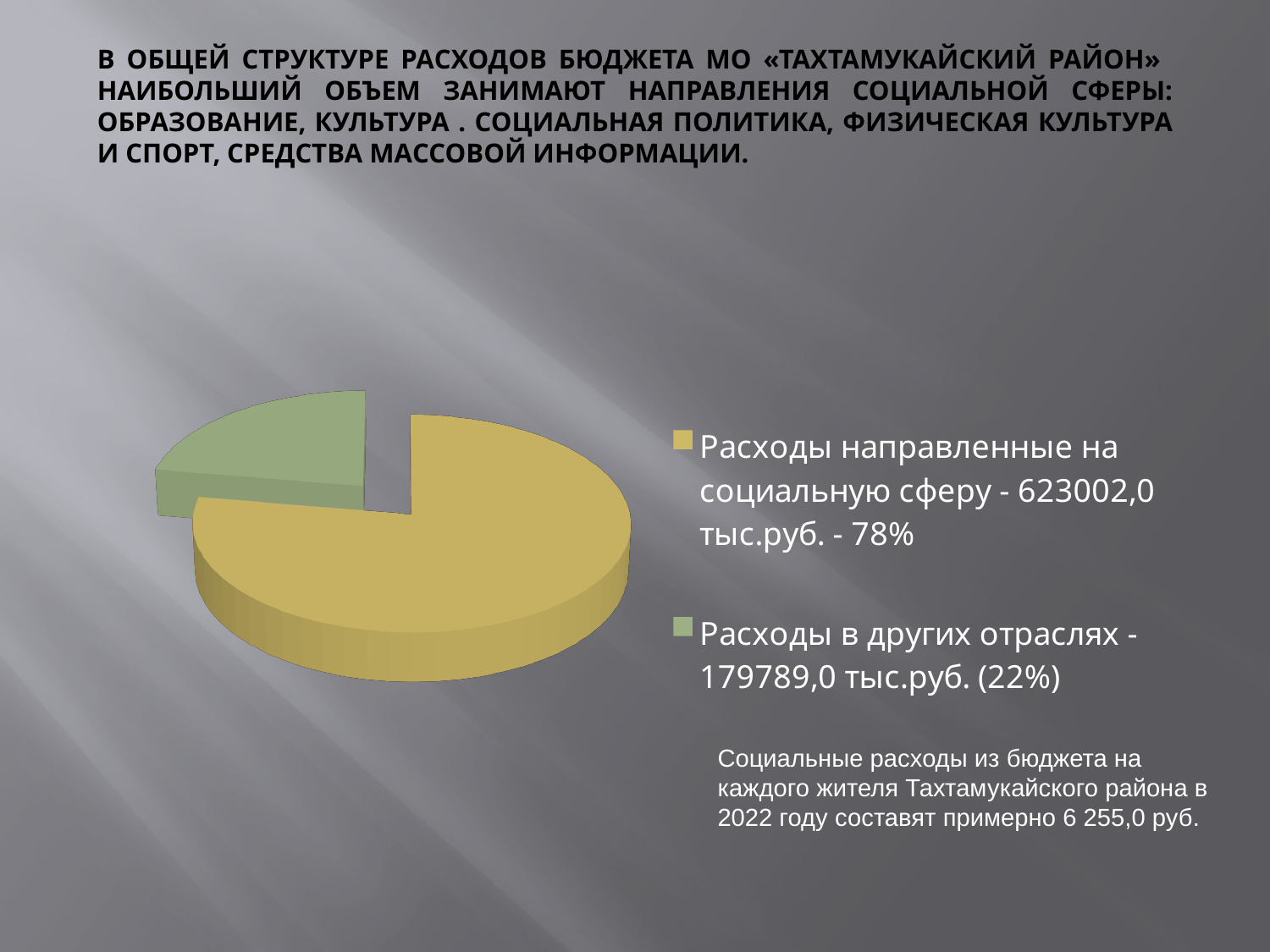
Which slice is the largest? Расходы направленные на социальную сферу How many entries does the legend list? 2 What is the difference between "Расходы направленные на социальную сферу" and "Расходы в других отраслях" in тыс.руб.? 443213,0 тыс.руб. How many slices does the pie chart have? 2 What share of the pie does "Расходы в других отраслях" take? 22% Which is larger: "Расходы направленные на социальную сферу" or "Расходы в других отраслях"? Расходы направленные на социальную сферу What is the value for "Расходы в других отраслях"? 179789,0 тыс.руб. What is the value for "Расходы направленные на социальную сферу"? 623002,0 тыс.руб. What colour is the slice for "Расходы в других отраслях"? green What kind of chart is shown on the slide? pie chart Which slice is the smallest? Расходы в других отраслях What share of the pie does "Расходы направленные на социальную сферу" take? 78%